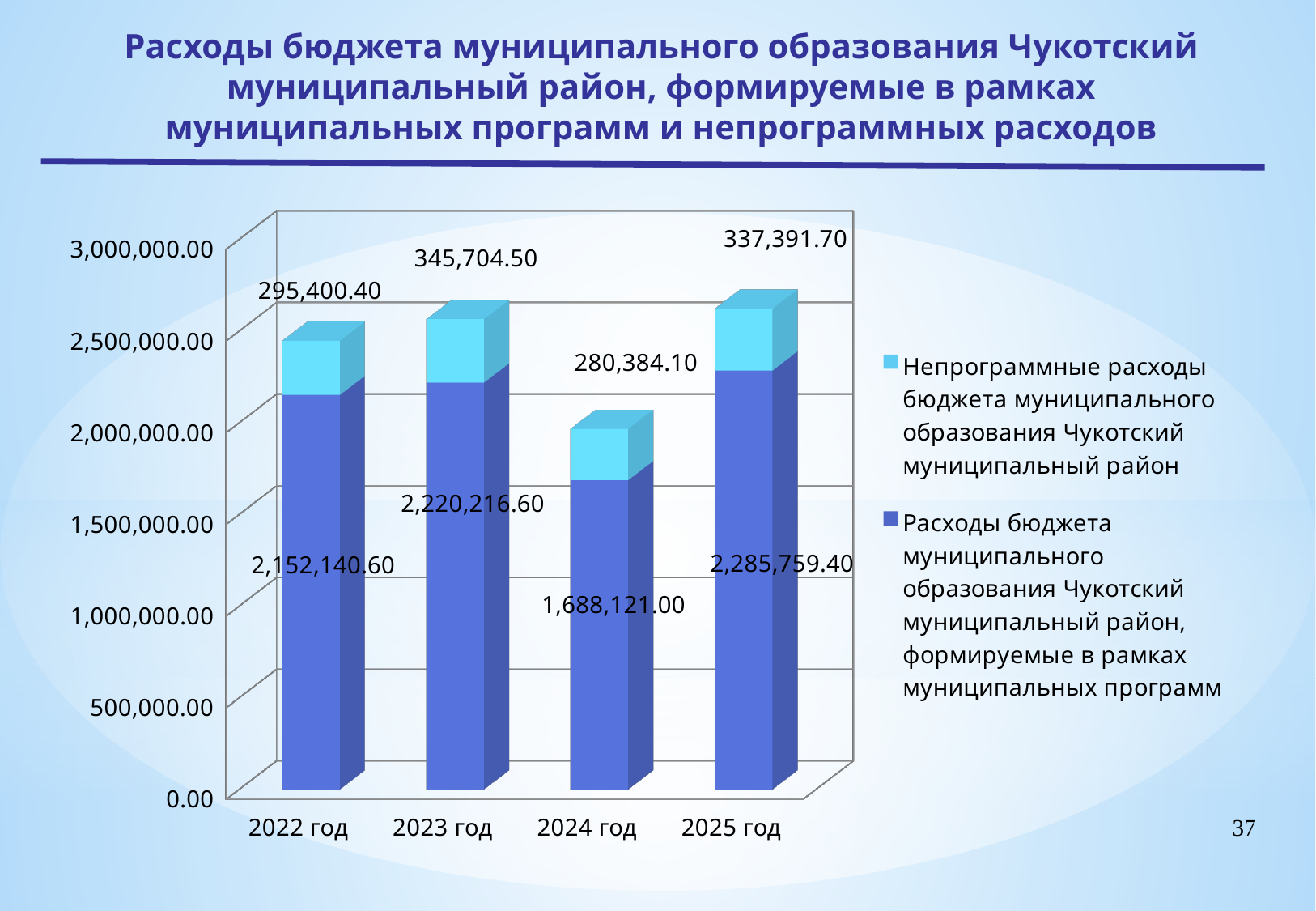
How many series does the legend list? 2 What is the total of the stacked bar for 2022 год? 2,447,541.00 Which year has the lowest program expenses? 2024 год How many years (categories) are shown on the x axis? 4 What is the difference between program expenses in 2025 год and 2024 год? 597,638.40 What is the value of program expenses (Расходы бюджета ... формируемые в рамках муниципальных программ) for 2024 год? 1,688,121.00 Which year has the highest non-program expenses? 2023 год What is the value of non-program expenses (Непрограммные расходы) for 2023 год? 345,704.50 What type of chart is shown on the slide? Stacked bar chart Which is larger: non-program expenses in 2022 год or in 2025 год? 2025 год What is the value of program expenses for 2025 год? 2,285,759.40 Which colour represents non-program expenses (Непрограммные расходы) in the chart? Light blue